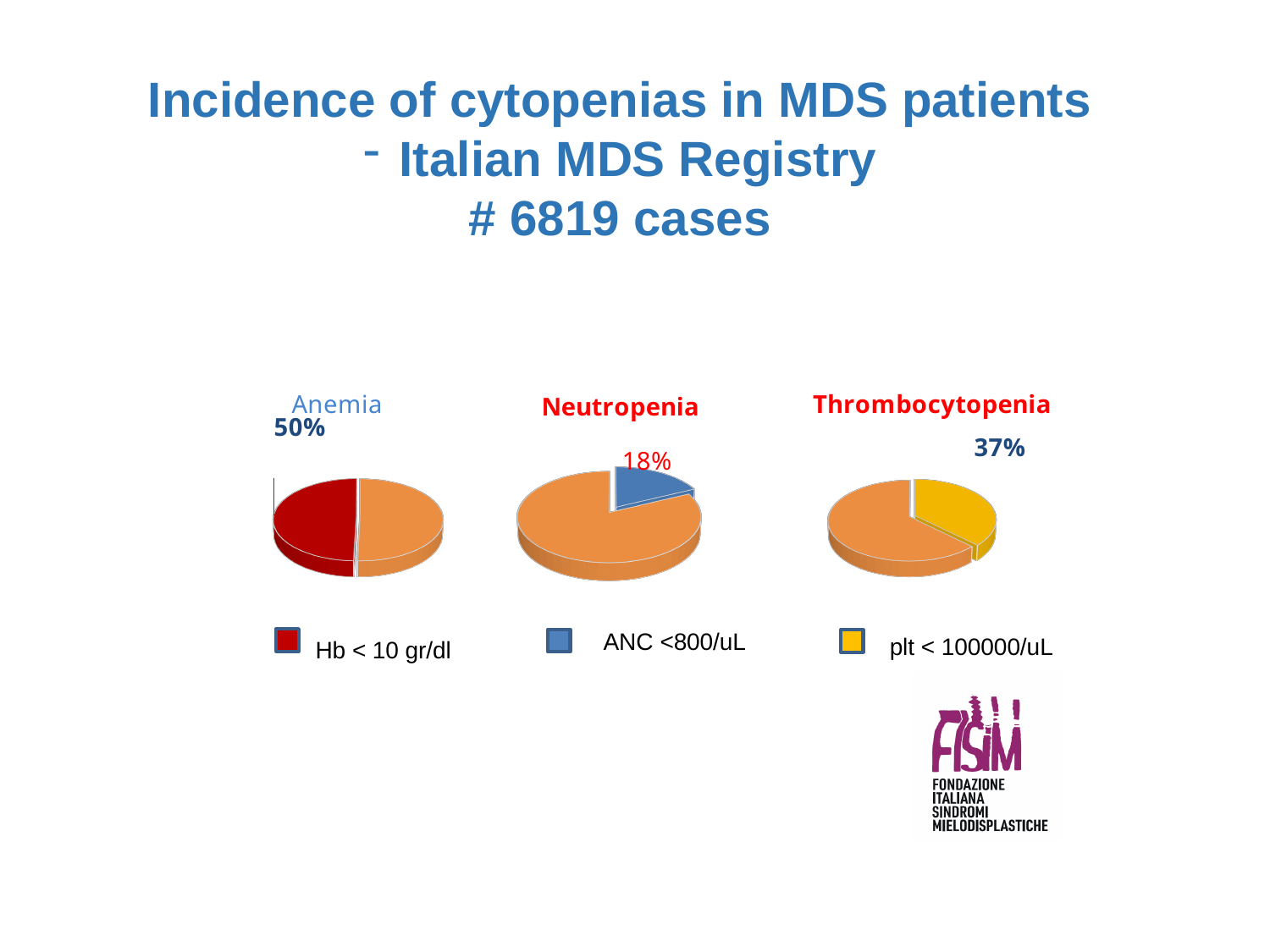
In the Neutropenia pie chart, what does the legend say the highlighted slice represents? ANC <800/uL Across the three pie charts, which cytopenia has the lowest labelled percentage? Neutropenia Which is larger: the labelled percentage in the Thrombocytopenia pie chart or the labelled percentage in the Neutropenia pie chart? Thrombocytopenia In the Thrombocytopenia pie chart, what percentage is shown for the highlighted slice? 37% What is the difference between the labelled percentage in the Anemia pie chart and the labelled percentage in the Neutropenia pie chart? 32% In the Thrombocytopenia pie chart, what colour is the highlighted slice? Yellow What kind of chart is used to show the incidence of each cytopenia on this slide? Pie chart Across the three pie charts, which cytopenia has the highest labelled percentage? Anemia What is the difference between the labelled percentage in the Thrombocytopenia pie chart and the labelled percentage in the Neutropenia pie chart? 19% In the Neutropenia pie chart, what percentage is shown for the highlighted slice? 18% How many pie charts are shown on the slide? 3 In the Anemia pie chart, what percentage is shown for the highlighted slice? 50%